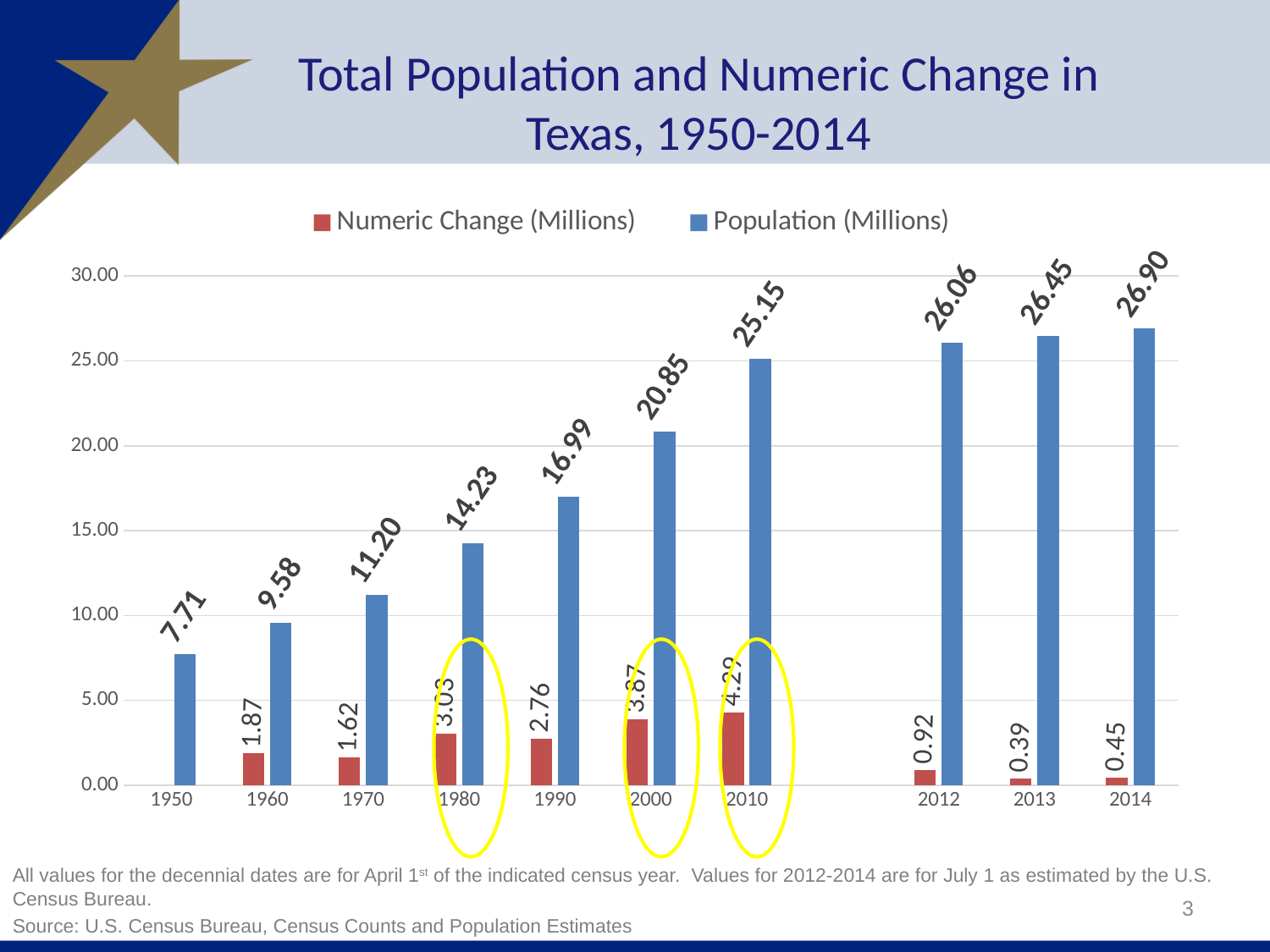
Which year has the larger Numeric Change (Millions) value, 1960 or 1970? 1960 How many years are shown on the x axis of the chart? 10 Is the Population (Millions) value for 2000 greater or less than 20.00? greater Which year has the lowest Population (Millions) value? 1950 Does the Population (Millions) series rise or fall from 1950 to 2014? rise How many series does the legend list? 2 Which year has the highest Population (Millions) value? 2014 What is the Population (Millions) value for 1950? 7.71 What is the difference between the Population (Millions) values for 2014 and 1950? 19.19 What is the Numeric Change (Millions) value for 1990? 2.76 What is the Population (Millions) value for 2014? 26.90 What is the Numeric Change (Millions) value for 2013? 0.39